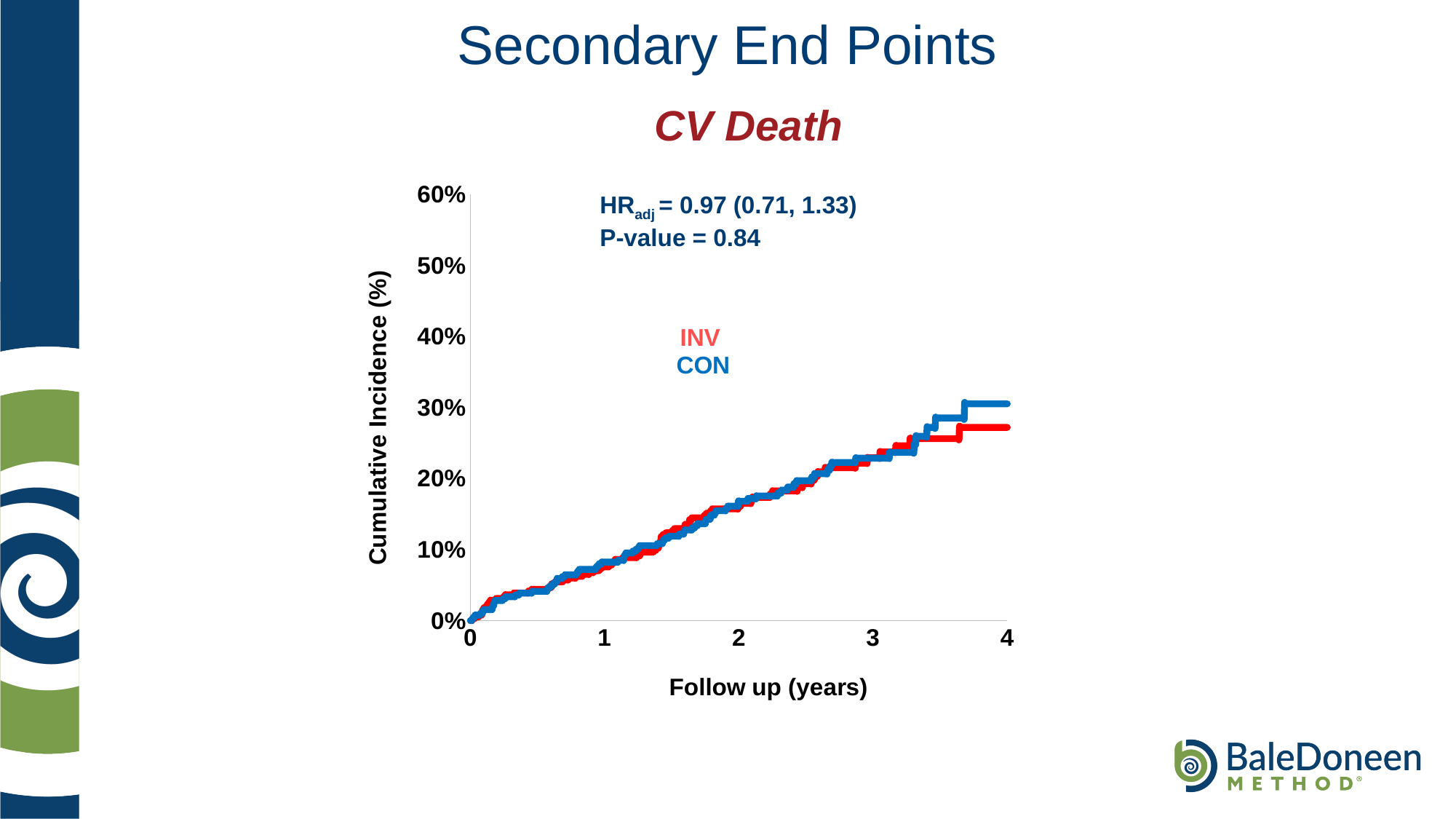
At 4 years of follow up, which series has the higher cumulative incidence, INV or CON? CON What is the label of the y axis in the CV Death chart? Cumulative Incidence (%) Is the cumulative incidence for CON at 2 years greater or less than 20%? less What kind of chart is shown on the slide? line chart What is the maximum value shown on the y axis of the CV Death chart? 60% How many series are plotted in the CV Death chart? 2 Is the cumulative incidence for INV at 2 years greater or less than 10%? greater What is the maximum follow-up time shown on the x axis of the CV Death chart? 4 Is the cumulative incidence for INV at 4 years greater or less than 30%? less Do the cumulative incidence curves rise or fall as follow-up years increase? rise